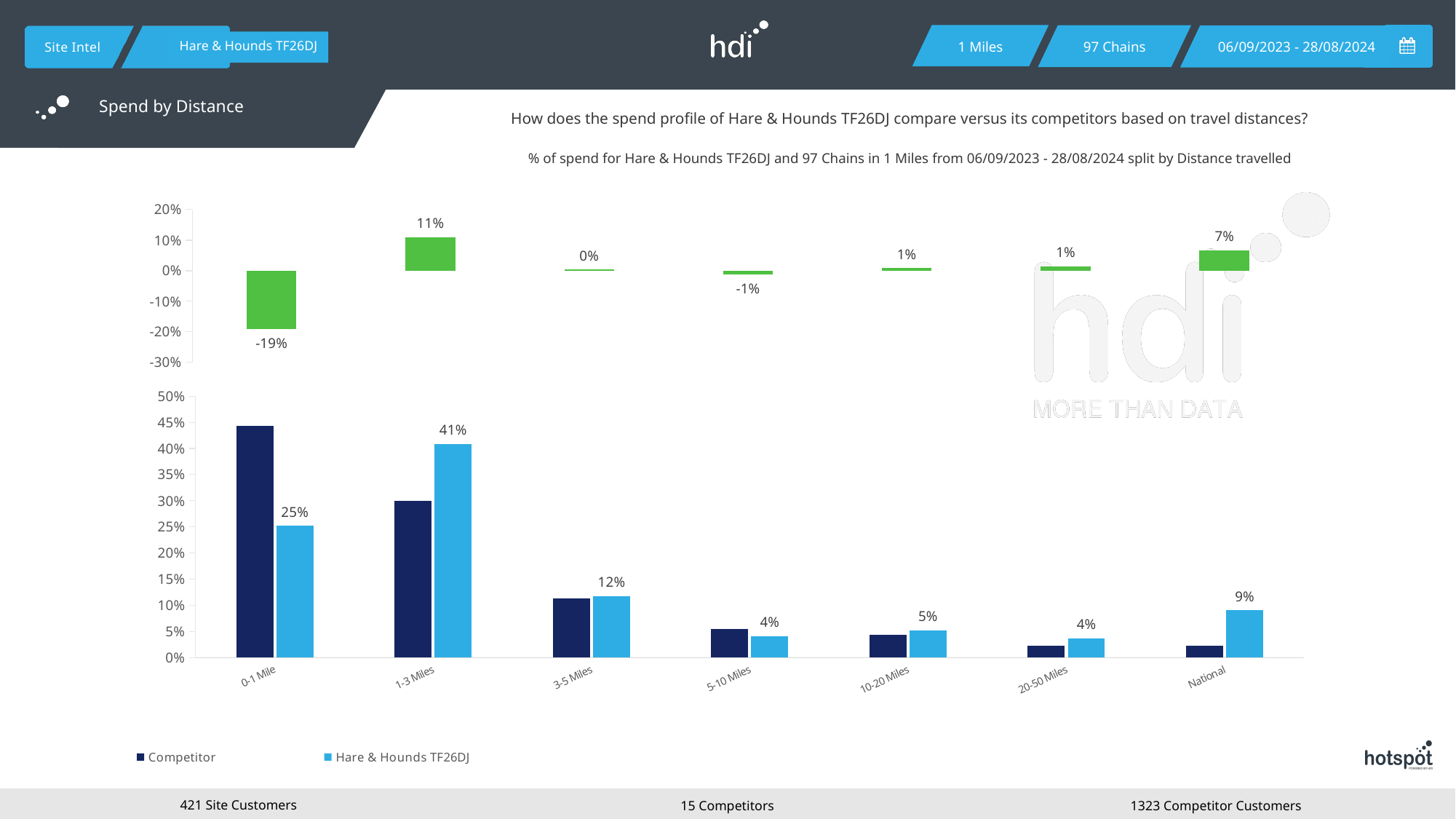
In the bottom chart, which is larger for the 0-1 Mile category: Competitor or Hare & Hounds TF26DJ? Competitor How many distance categories are shown on the x axis of the bottom chart? 7 How many series does the legend of the bottom chart list? 2 In the top chart, what is the value shown for the 0-1 Mile category? -19% In the bottom chart, what is the value for Hare & Hounds TF26DJ in the 0-1 Mile category? 25% In the top chart, which category has the highest value? 1-3 Miles In the top chart, what is the value shown for the National category? 7% In the bottom chart, is the Competitor value for 0-1 Mile greater or less than 40%? greater In the bottom chart, is the Competitor value for 20-50 Miles greater or less than 5%? less In the bottom chart, what is the value for Hare & Hounds TF26DJ in the 1-3 Miles category? 41% In the bottom chart, which category has the lowest labelled value for Hare & Hounds TF26DJ? 5-10 Miles and 20-50 Miles (both 4%) In the bottom chart, what is the difference between the Hare & Hounds TF26DJ values for 1-3 Miles and 0-1 Mile? 16 percentage points